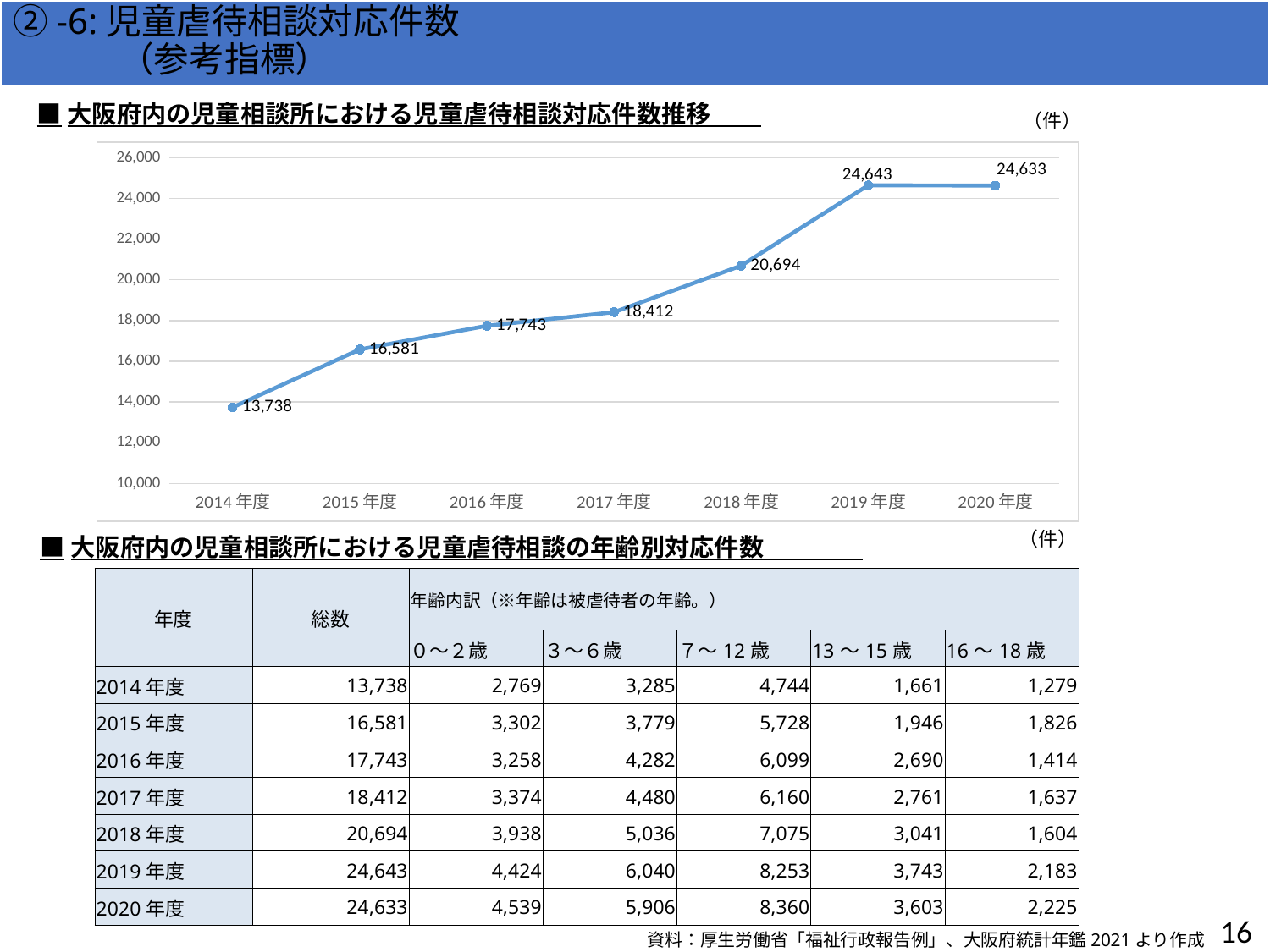
How many fiscal years are plotted in the line chart? 7 Which fiscal year has the highest value in the line chart? 2019年度 By how much did the value increase from 2018年度 to 2019年度 in the line chart? 3,949 What value is shown for 2018年度 in the line chart? 20,694 Does the value in the line chart generally rise or fall from 2014年度 to 2019年度? Rise Is the value for 2015年度 in the line chart greater or less than 16,000? greater What kind of chart is used to show the trend of child abuse consultation cases in Osaka Prefecture? Line chart What is the difference between the 2020年度 value and the 2014年度 value in the line chart? 10,895 What value is shown for 2020年度 in the line chart? 24,633 Which is larger in the line chart, the value for 2016年度 or the value for 2017年度? 2017年度 Which fiscal year has the lowest value in the line chart? 2014年度 What is the number of child abuse consultation cases for 2014年度 in the line chart? 13,738